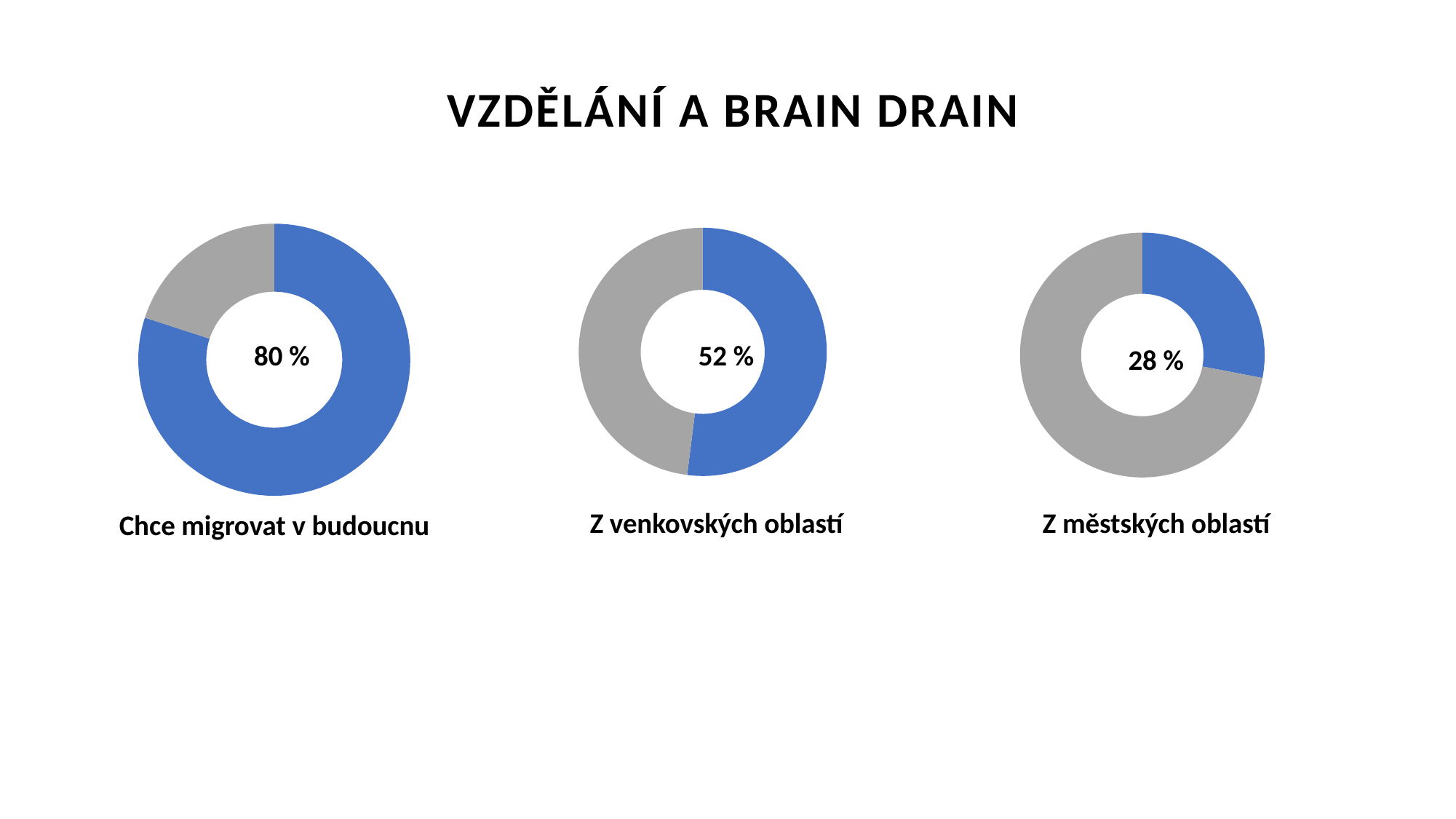
In the donut chart labelled "Z městských oblastí", what share of the ring is the blue segment? 28 % Which is larger: the percentage for "Z venkovských oblastí" or the percentage for "Z městských oblastí"? Z venkovských oblastí What is the difference between the percentage for "Z venkovských oblastí" and the percentage for "Z městských oblastí"? 24 % What value is shown in the centre of the donut chart labelled "Z venkovských oblastí"? 52 % What kind of chart is used for "Chce migrovat v budoucnu"? Donut chart What is the title of the slide? VZDĚLÁNÍ A BRAIN DRAIN How many donut charts are shown on the slide? 3 What is the difference between the percentage for "Chce migrovat v budoucnu" and the percentage for "Z venkovských oblastí"? 28 % Which of the three donut charts shows the lowest percentage? Z městských oblastí Which of the three donut charts shows the highest percentage? Chce migrovat v budoucnu What value is shown in the centre of the donut chart labelled "Chce migrovat v budoucnu"? 80 % What value is shown in the centre of the donut chart labelled "Z městských oblastí"? 28 %